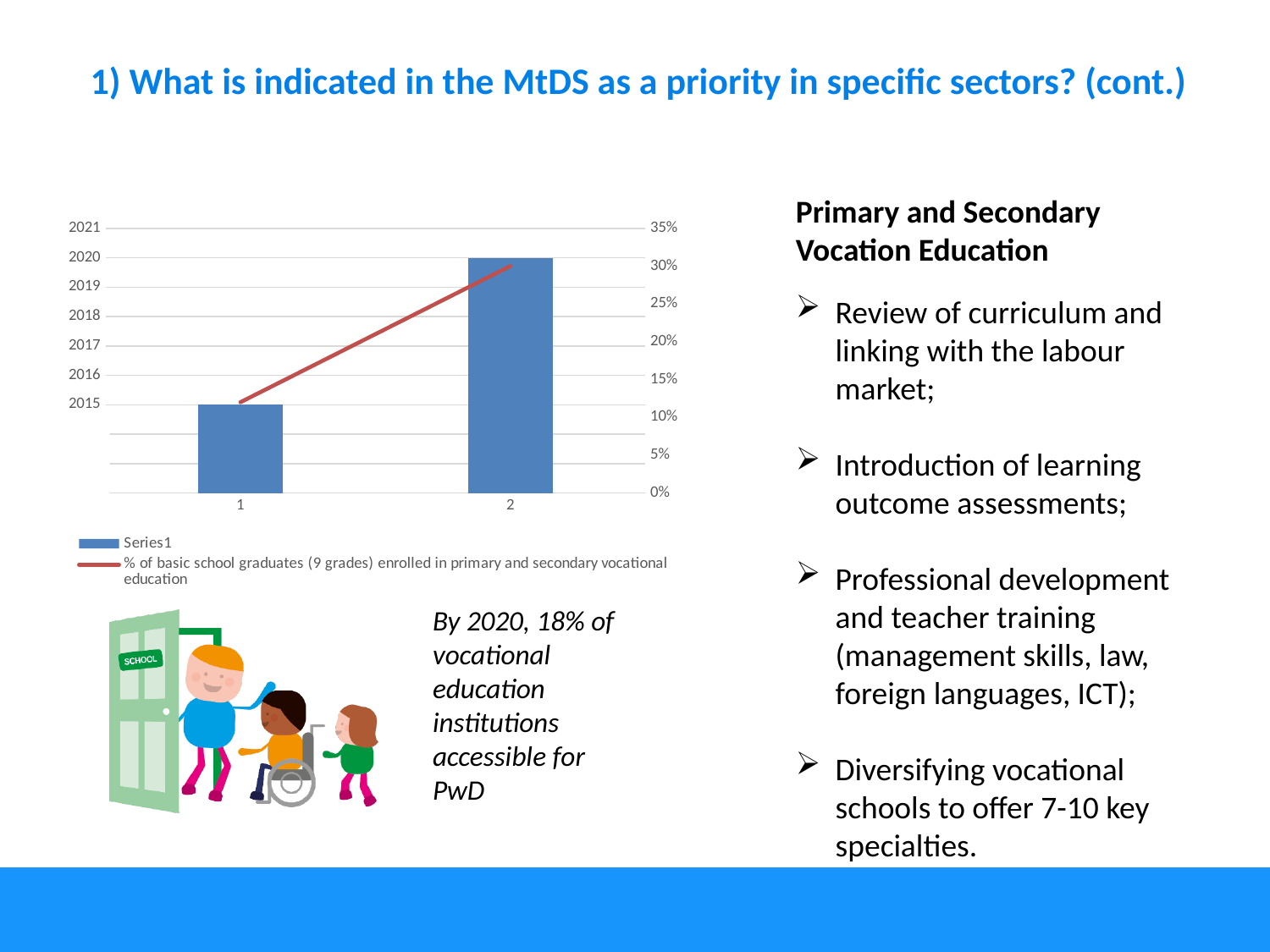
On the left axis, which year tick does the Series1 bar for category 2 reach? 2020 Is the line value for category 2 on the right axis greater or less than 25%? greater What kind of chart is shown on the slide? bar and line chart Which category has the taller Series1 bar, 1 or 2? 2 Is the line value for category 1 on the right axis greater or less than 15%? less On the left axis, which year tick does the Series1 bar for category 1 reach? 2015 How many series does the chart legend list? 2 What is the highest percentage tick shown on the right axis of the chart? 35% How many categories are shown on the x axis of the chart? 2 Is the Series1 bar for category 2 larger or smaller than the bar for category 1? larger Do the values rise or fall from category 1 to category 2? rise Which category has the shorter Series1 bar? 1